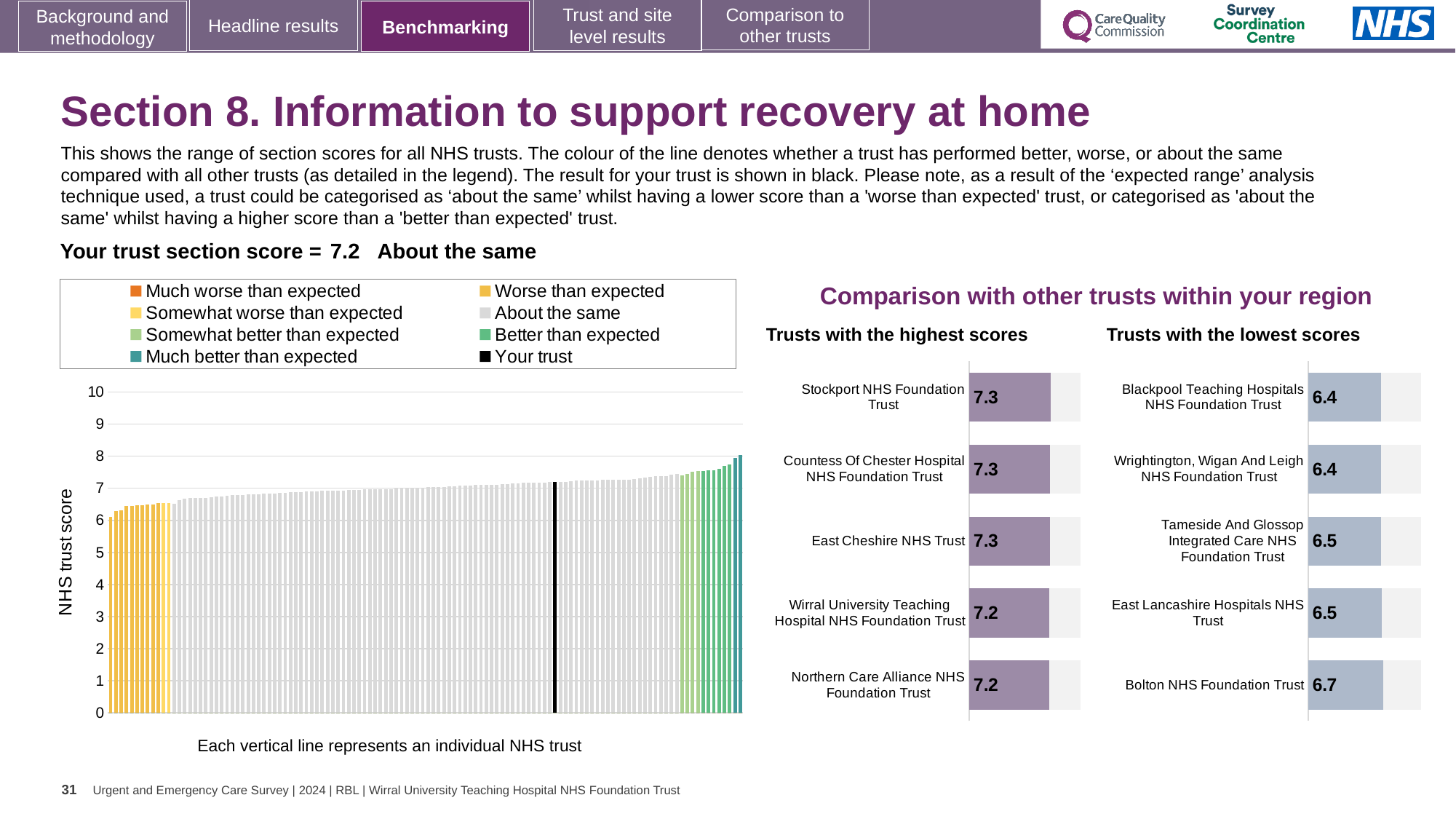
What kind of chart is the main chart on the left showing NHS trust scores? Bar chart In the 'Trusts with the lowest scores' chart, what is the score for Blackpool Teaching Hospitals NHS Foundation Trust? 6.4 In the main chart on the left, what is the section score for your trust? 7.2 In the 'Trusts with the highest scores' chart, what is the score for Stockport NHS Foundation Trust? 7.3 In the 'Trusts with the lowest scores' chart, what is the score for Bolton NHS Foundation Trust? 6.7 In the 'Trusts with the lowest scores' chart, what is the difference between the scores of Bolton NHS Foundation Trust and Blackpool Teaching Hospitals NHS Foundation Trust? 0.3 In the main chart on the left, do the NHS trust scores rise or fall from left to right? Rise In the 'Trusts with the highest scores' chart, what is the score for Northern Care Alliance NHS Foundation Trust? 7.2 How many entries does the legend of the main chart on the left list? 8 In the 'Trusts with the lowest scores' chart, which trust has the highest score? Bolton NHS Foundation Trust How many trusts are shown in the 'Trusts with the highest scores' chart? 5 In the 'Trusts with the highest scores' chart, which has the larger score: Stockport NHS Foundation Trust or Wirral University Teaching Hospital NHS Foundation Trust? Stockport NHS Foundation Trust